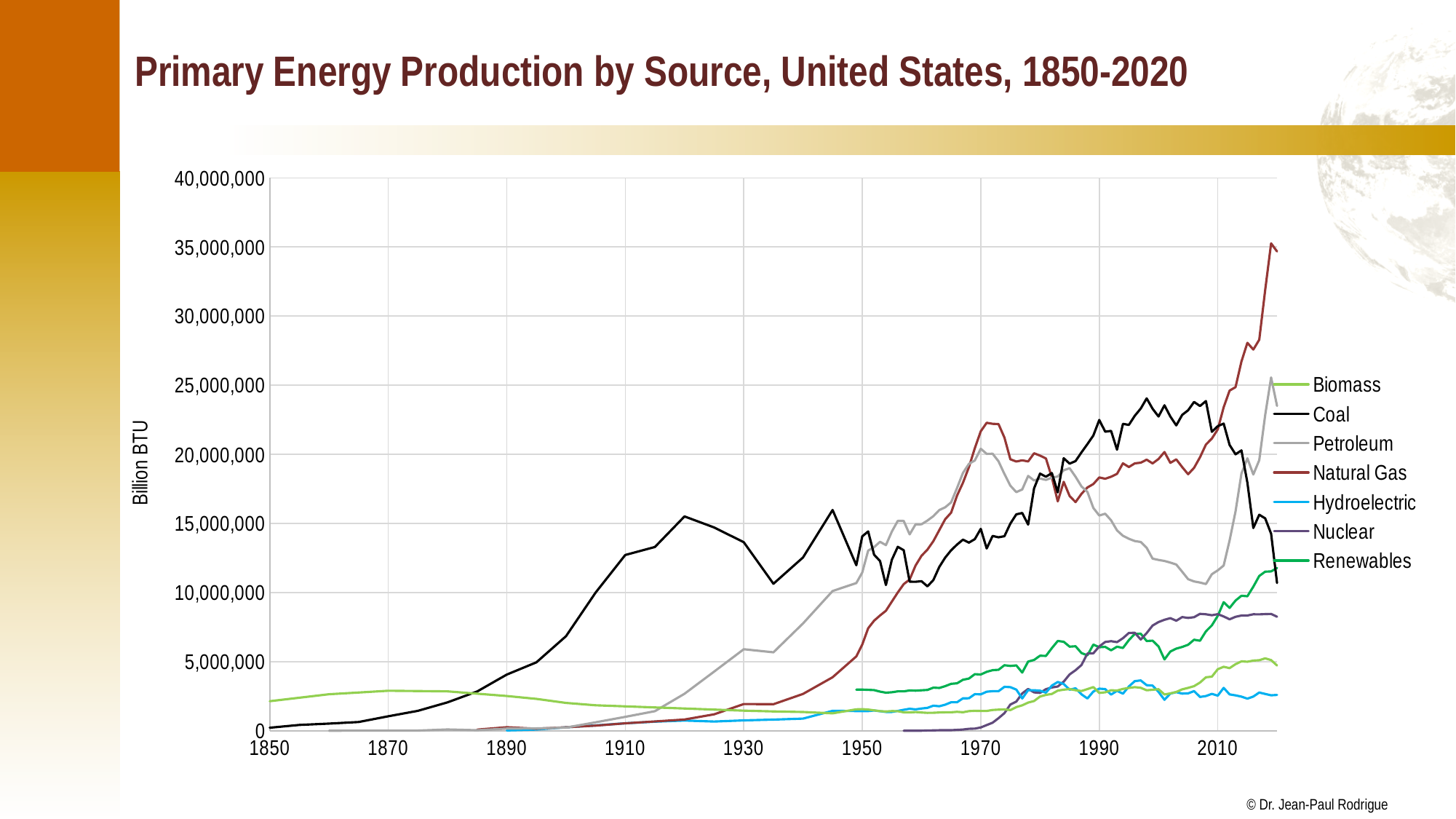
Is the value for Coal in 1910 greater or less than 10,000,000? greater What kind of chart is shown on the slide? line chart Which series has the highest value at the right end of the chart (2020)? Natural Gas At the end of the chart (2020), which is larger: Renewables or Biomass? Renewables Which series has the lowest value at the right end of the chart (2020)? Hydroelectric How many series does the legend list? 7 Is the value for Petroleum in 1970 greater or less than 15,000,000? greater Does the Coal line rise or fall between 2010 and 2020? fall Is the value for Natural Gas at the end of the chart (2020) greater or less than 30,000,000? greater What is the label on the vertical axis? Billion BTU Which series are listed in the legend? Biomass, Coal, Petroleum, Natural Gas, Hydroelectric, Nuclear, Renewables